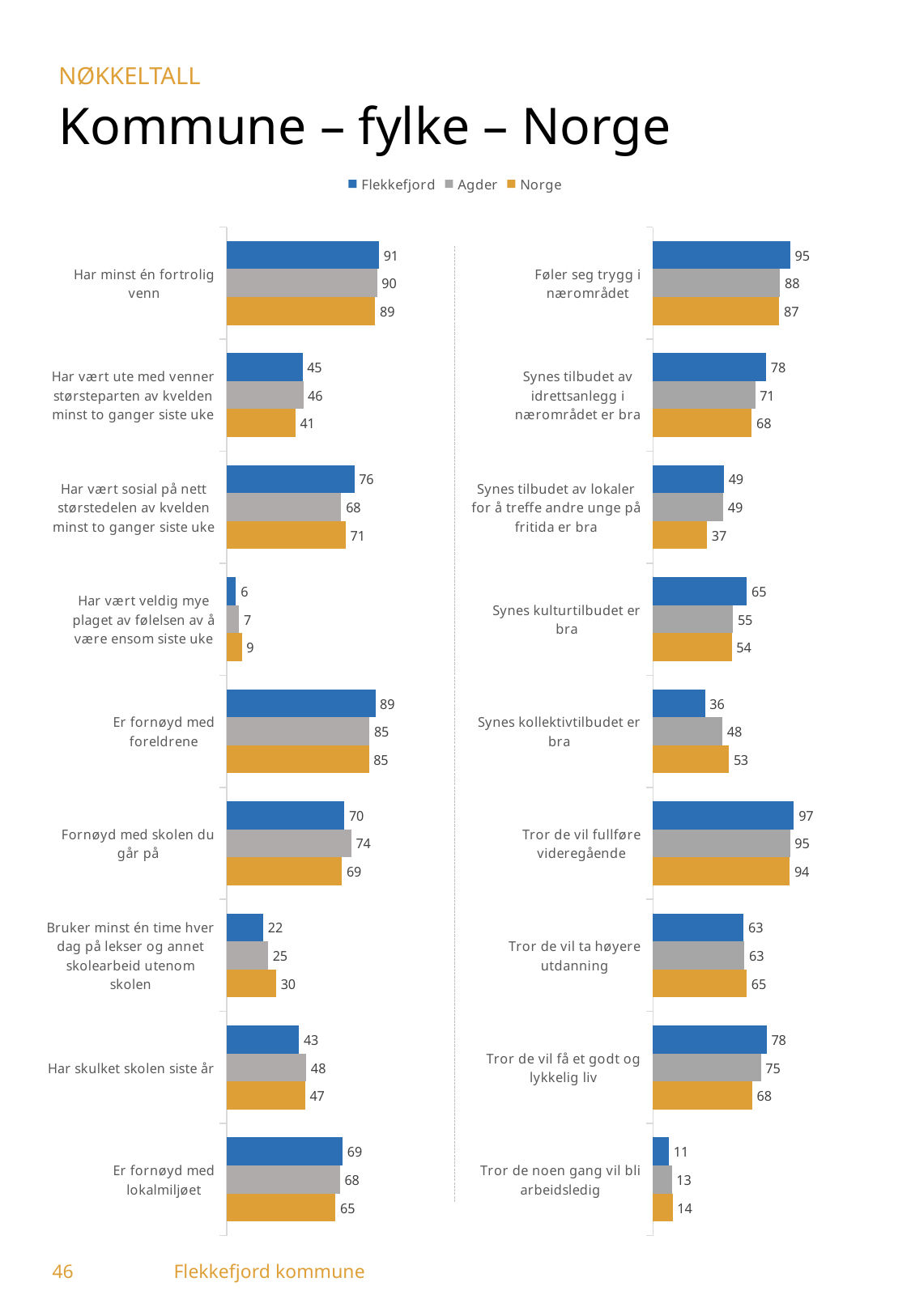
In the left chart, which is larger for 'Fornøyd med skolen du går på': the Flekkefjord value or the Agder value? Agder How many series does the legend list? 3 In the left chart, what is the Flekkefjord value for 'Har minst én fortrolig venn'? 91 How many categories does the left chart show? 9 In the right chart, which is larger for 'Synes kollektivtilbudet er bra': the Flekkefjord value or the Norge value? Norge In the right chart, what is the Norge value for 'Synes tilbudet av lokaler for å treffe andre unge på fritida er bra'? 37 In the left chart, which category has the lowest Flekkefjord value? Har vært veldig mye plaget av følelsen av å være ensom siste uke In the right chart, what is the difference between the Flekkefjord and Norge values for 'Tror de vil få et godt og lykkelig liv'? 10 What type of chart is used on this slide? Bar chart In the right chart, which category has the highest Flekkefjord value? Tror de vil fullføre videregående In the right chart, what is the Agder value for 'Synes kollektivtilbudet er bra'? 48 In the left chart, what is the difference between the Flekkefjord and Agder values for 'Har vært sosial på nett størstedelen av kvelden minst to ganger siste uke'? 8